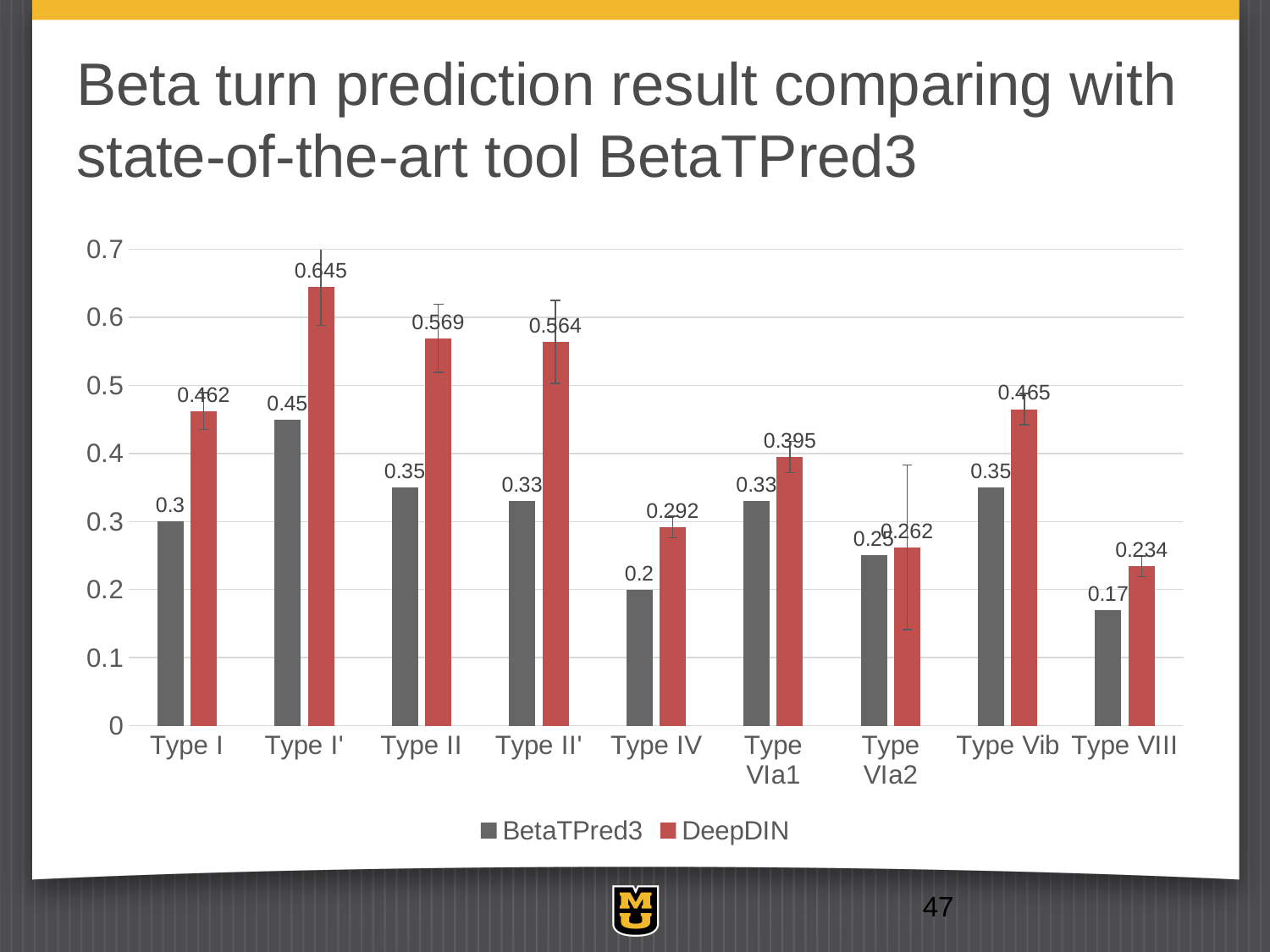
What is the DeepDIN value for Type I'? 0.645 What kind of chart is shown on the slide? bar chart For Type IV, which tool has the larger value, BetaTPred3 or DeepDIN? DeepDIN Which beta turn type has the highest DeepDIN value? Type I' Is the DeepDIN value for Type II' greater or less than 0.5? greater What colour represents DeepDIN in the chart? red What is the BetaTPred3 value for Type VIII? 0.17 What is the DeepDIN value for Type VIb? 0.465 How many beta turn types are shown on the x axis? 9 How many series does the legend list? 2 For Type II, how much higher is the DeepDIN value than the BetaTPred3 value? 0.219 Which beta turn type has the lowest BetaTPred3 value? Type VIII